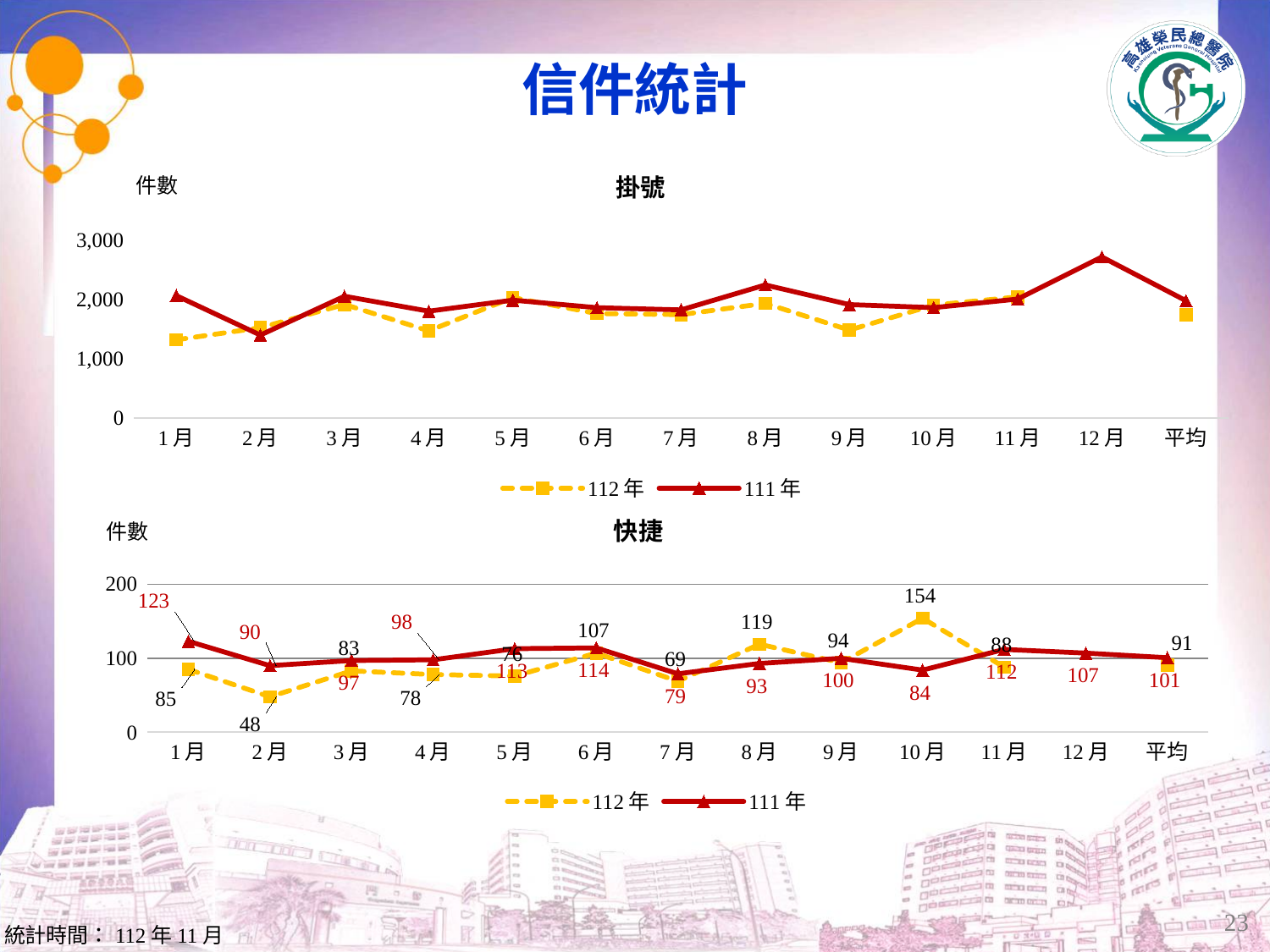
In the 快捷 chart, which series has the larger value in 1月, 112年 or 111年? 111年 What kind of chart is the 快捷 chart at the bottom of the slide? line chart In the 快捷 chart, what is the difference between the 112年 and 111年 values in 10月? 70 How many series does the legend of the 快捷 chart list? 2 In the 快捷 chart, what is the 平均 value for 111年? 101 In the 掛號 chart, is the value for 112年 in 1月 greater or less than 2,000? less In the 快捷 chart, which month has the highest value for 111年? 1月 In the 快捷 chart, which month has the highest value for 112年? 10月 In the 掛號 chart, is the value for 111年 in 12月 greater or less than 2,000? greater In the 快捷 chart, what is the value for 112年 in 10月? 154 In the 快捷 chart, what is the value for 111年 in 1月? 123 In the 快捷 chart, which month has the lowest value for 112年? 2月